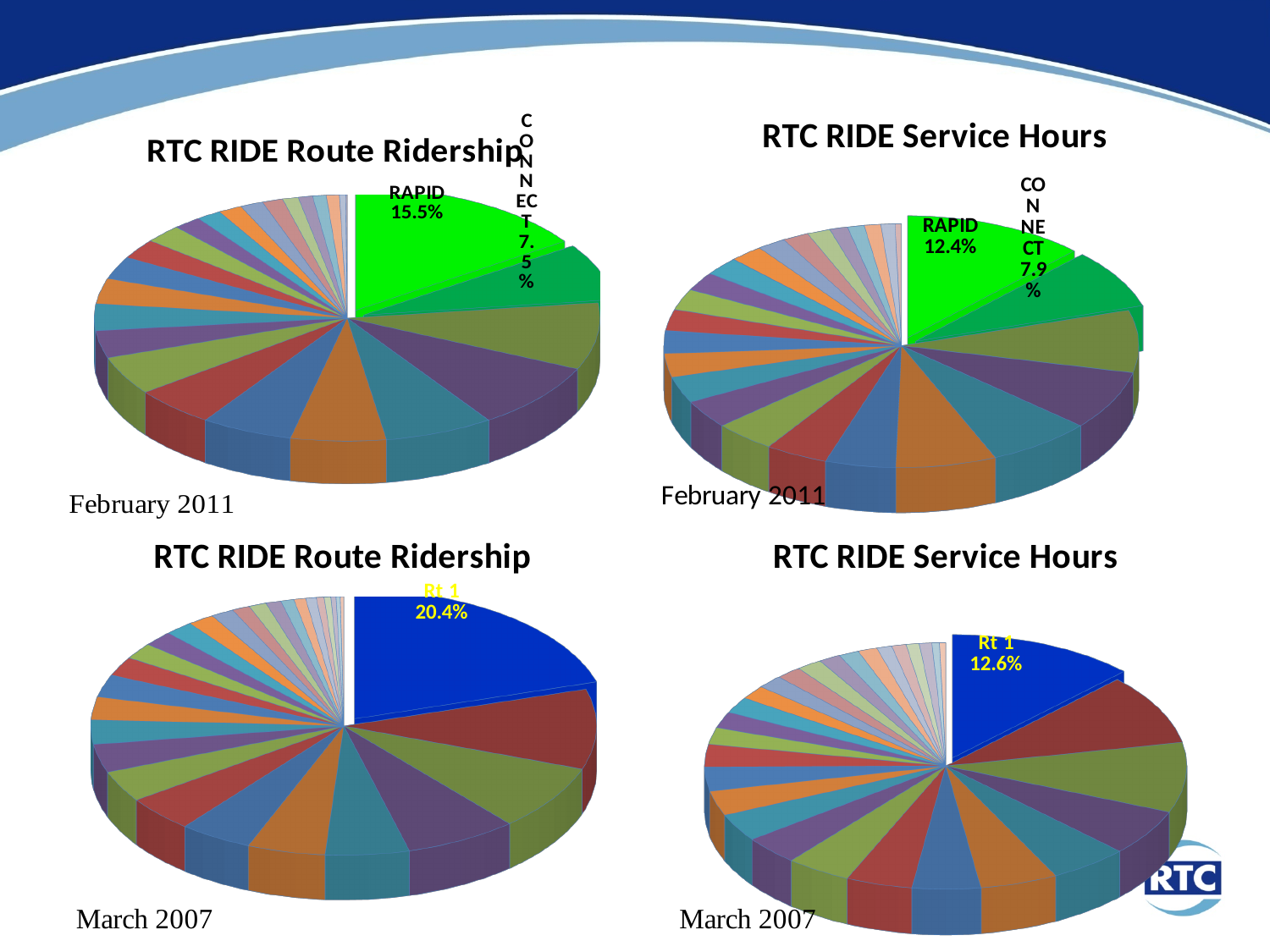
In the top-right chart (RTC RIDE Service Hours, February 2011), what is the difference between the RAPID share and the CONNECT share? 4.5% What type of chart is used for the RTC RIDE Route Ridership and Service Hours data on this slide? Pie chart Is the Rt 1 share in the bottom-left chart (Route Ridership, March 2007) larger or smaller than the Rt 1 share in the bottom-right chart (Service Hours, March 2007)? larger In the top-right chart (RTC RIDE Service Hours, February 2011), what share does CONNECT have? 7.9% In the top-right chart (RTC RIDE Service Hours, February 2011), what share of service hours does RAPID have? 12.4% In the top-left chart (RTC RIDE Route Ridership, February 2011), what share of ridership does RAPID have? 15.5% In the top-left chart (RTC RIDE Route Ridership, February 2011), what is the difference between the RAPID share and the CONNECT share? 8.0% In the top-left chart (RTC RIDE Route Ridership, February 2011), which is larger, the RAPID slice or the CONNECT slice? RAPID How many pie charts are shown on the slide? 4 In the bottom-left chart (RTC RIDE Route Ridership, March 2007), what share of ridership does Rt 1 have? 20.4% In the top-left chart (RTC RIDE Route Ridership, February 2011), what share does CONNECT have? 7.5% In the bottom-right chart (RTC RIDE Service Hours, March 2007), what share of service hours does Rt 1 have? 12.6%